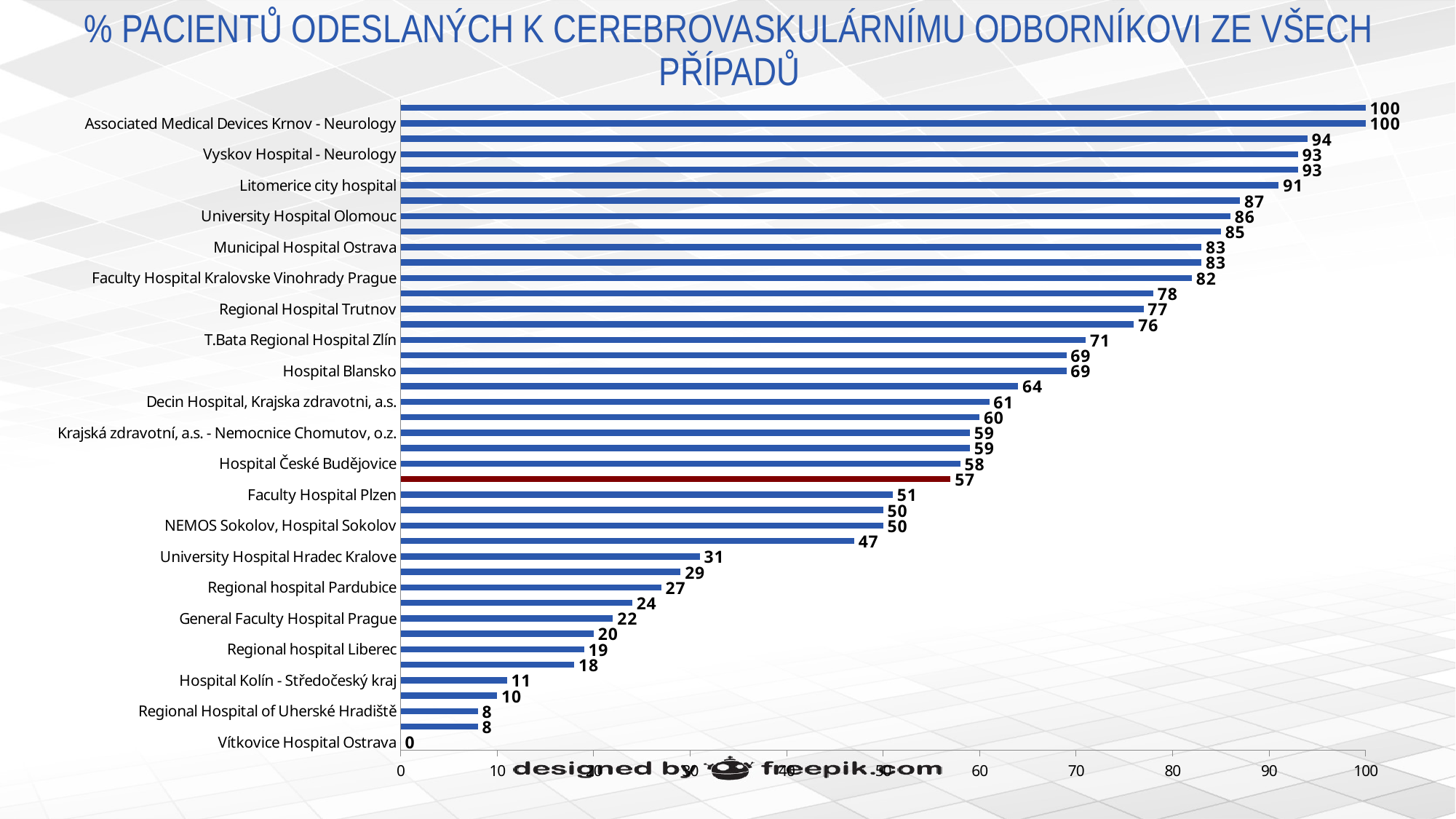
Is the value for Hospital Blansko greater or less than 60? greater What is the difference between the values for Associated Medical Devices Krnov - Neurology and Vítkovice Hospital Ostrava? 100 Which has a larger value, Hospital Blansko or NEMOS Sokolov, Hospital Sokolov? Hospital Blansko What kind of chart is shown on the slide? bar chart Which labelled hospital has the lowest value? Vítkovice Hospital Ostrava What is the value for Associated Medical Devices Krnov - Neurology? 100 What is the value for Vítkovice Hospital Ostrava? 0 What is the value for NEMOS Sokolov, Hospital Sokolov? 50 Which labelled hospital has the highest value? Associated Medical Devices Krnov - Neurology What is the value for Hospital Blansko? 69 How many bars are plotted in the chart? 42 What value is labelled on the single red bar in the chart? 57